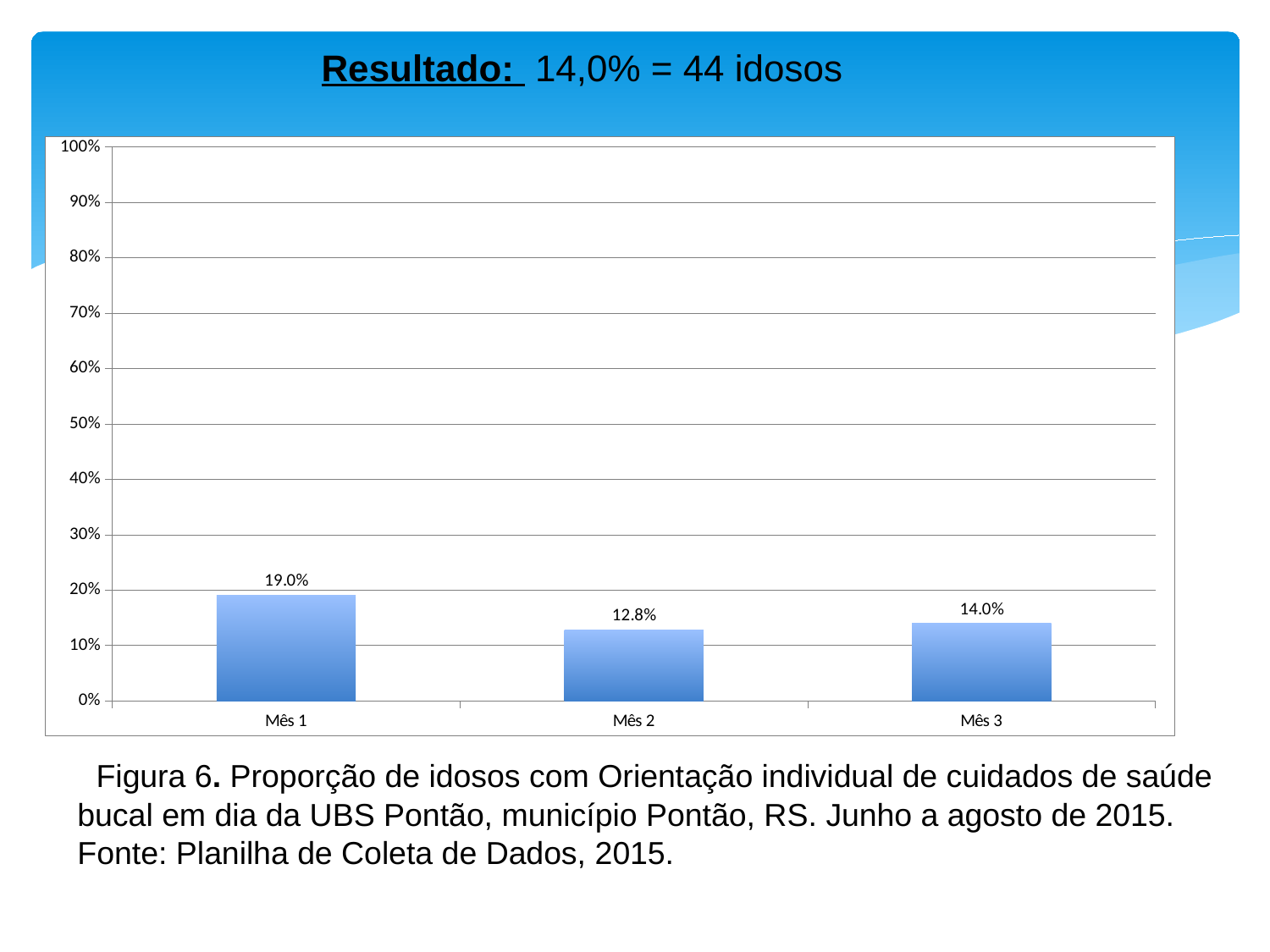
How many months are shown on the x axis? 3 What kind of chart is shown on the slide? bar chart Which month has the lowest value? Mês 2 What is the maximum value shown on the y axis? 100% What is the value for Mês 2? 12.8% Which month has the highest value? Mês 1 What is the value for Mês 1? 19.0% Is the value for Mês 1 greater or less than 20%? less What is the value for Mês 3? 14.0% What is the difference between the values for Mês 3 and Mês 2? 1.2% What is the difference between the values for Mês 1 and Mês 2? 6.2% Which is larger, the value for Mês 1 or the value for Mês 3? Mês 1